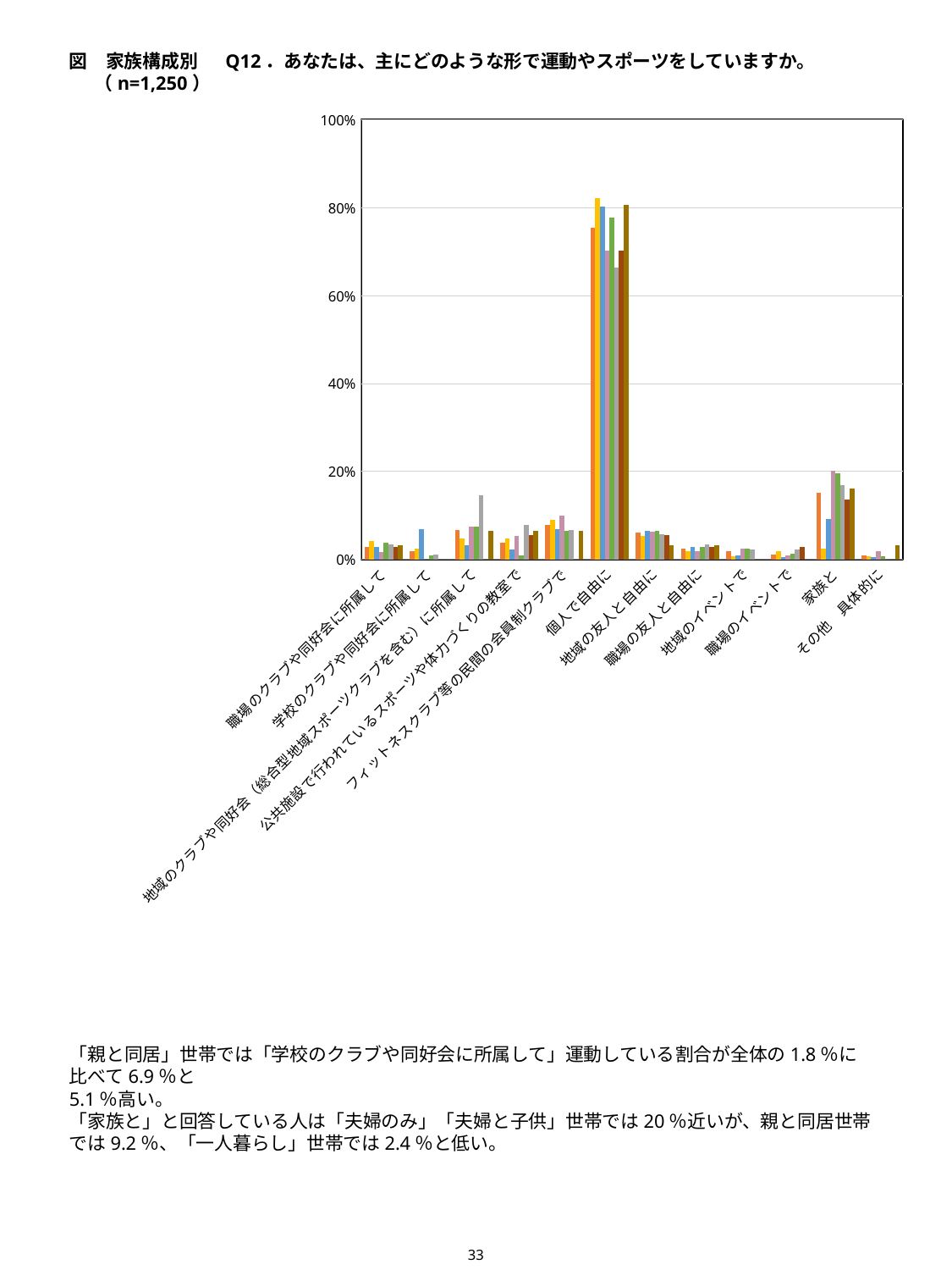
Are the values for 家族と greater or less than 40%? less Are the values for 個人で自由に greater or less than 60%? greater How many categories are shown along the x axis of the chart? 12 Are the values for 職場のイベントで greater or less than 20%? less What is the sample size (n) stated in the chart title? n=1,250 What kind of chart is shown on the slide? bar chart Which category has larger values, 個人で自由に or 家族と? 個人で自由に Which category has the highest bars in the chart? 個人で自由に What is the maximum value shown on the vertical axis of the chart? 100% Which category has larger values, 家族と or 職場のイベントで? 家族と